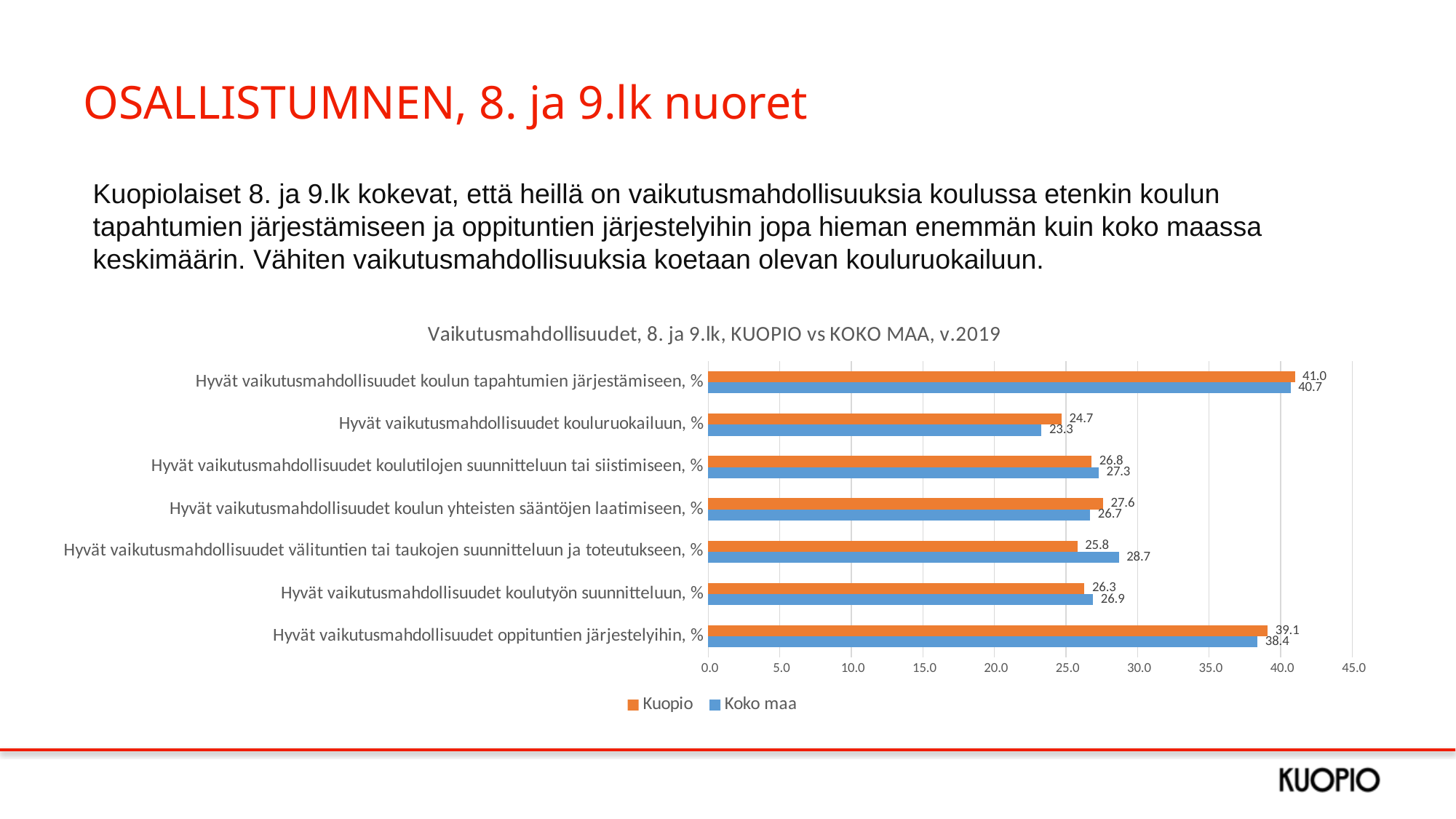
How many categories are shown in the chart? 7 What is the Kuopio value for 'Hyvät vaikutusmahdollisuudet koulun tapahtumien järjestämiseen, %'? 41.0 How many series does the legend list? 2 Which category has the lowest Koko maa value? Hyvät vaikutusmahdollisuudet kouluruokailuun, % For 'Hyvät vaikutusmahdollisuudet välituntien tai taukojen suunnitteluun ja toteutukseen, %', which is larger: Kuopio or Koko maa? Koko maa What is the title of the chart? Vaikutusmahdollisuudet, 8. ja 9.lk, KUOPIO vs KOKO MAA, v.2019 What kind of chart is shown on the slide? Bar chart What is the Koko maa value for 'Hyvät vaikutusmahdollisuudet välituntien tai taukojen suunnitteluun ja toteutukseen, %'? 28.7 Is the Kuopio value for 'Hyvät vaikutusmahdollisuudet kouluruokailuun, %' greater or less than 25.0? less What is the difference between the Kuopio and Koko maa values for 'Hyvät vaikutusmahdollisuudet oppituntien järjestelyihin, %'? 0.7 What is the Koko maa value for 'Hyvät vaikutusmahdollisuudet kouluruokailuun, %'? 23.3 Which category has the highest Kuopio value? Hyvät vaikutusmahdollisuudet koulun tapahtumien järjestämiseen, %